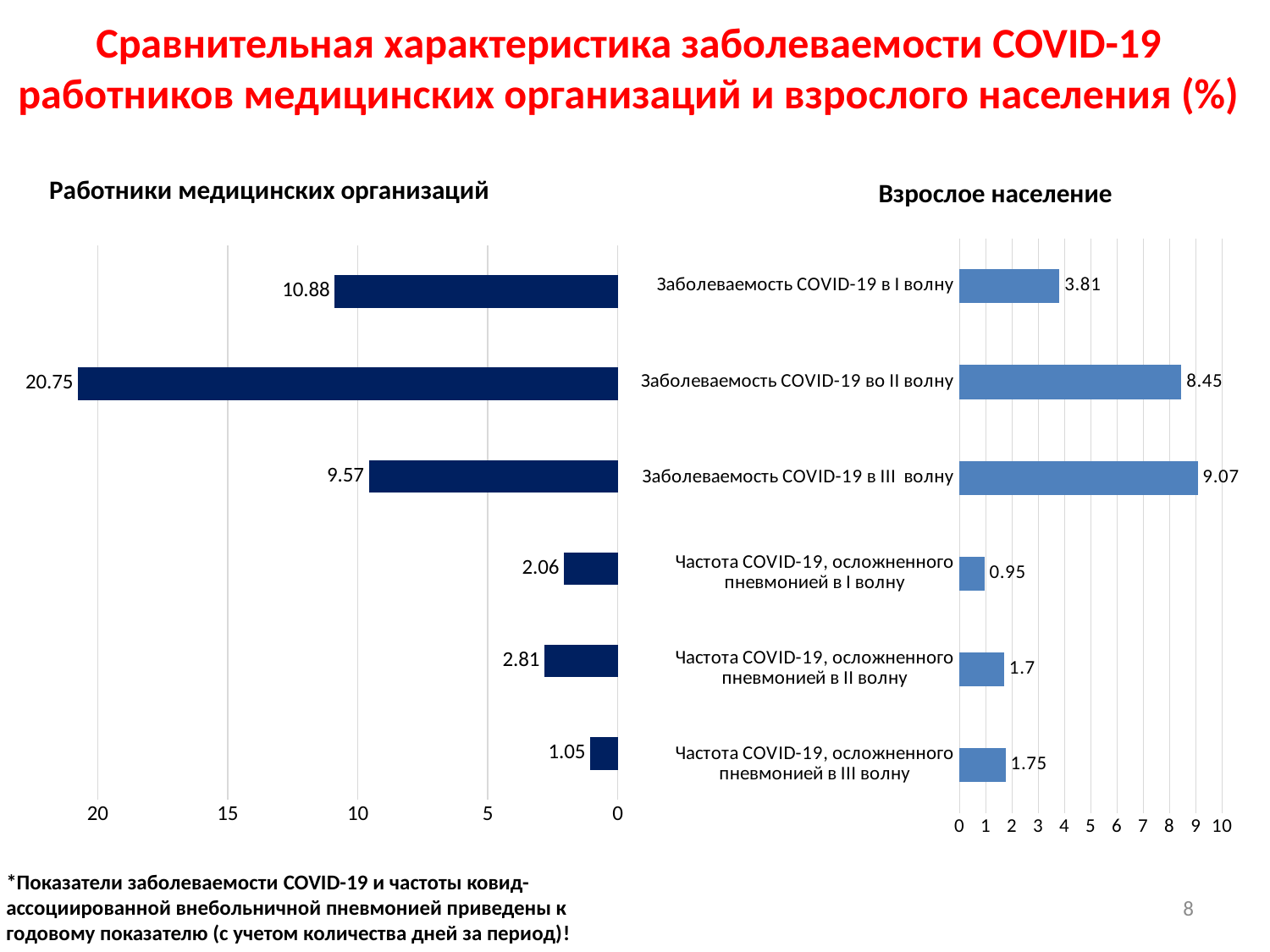
In the 'Взрослое население' chart, which category has the lowest value? Частота COVID-19, осложненного пневмонией в I волну In the 'Взрослое население' chart, what is the value for 'Заболеваемость COVID-19 в III волну'? 9.07 In the 'Работники медицинских организаций' chart, which category has the highest value? Заболеваемость COVID-19 во II волну In the 'Взрослое население' chart, what is the difference between the values for 'Заболеваемость COVID-19 во II волну' and 'Заболеваемость COVID-19 в I волну'? 4.64 In the 'Работники медицинских организаций' chart, which category has the lowest value? Частота COVID-19, осложненного пневмонией в III волну In the 'Взрослое население' chart, what is the value for 'Частота COVID-19, осложненного пневмонией в I волну'? 0.95 What type of chart is the 'Работники медицинских организаций' chart? Bar chart In the 'Работники медицинских организаций' chart, what is the difference between the values for 'Заболеваемость COVID-19 в I волну' and 'Заболеваемость COVID-19 в III волну'? 1.31 How many categories are shown in the 'Взрослое население' chart? 6 In the 'Работники медицинских организаций' chart, which is larger: the value for 'Частота COVID-19, осложненного пневмонией в I волну' or 'Частота COVID-19, осложненного пневмонией в II волну'? Частота COVID-19, осложненного пневмонией в II волну In the 'Работники медицинских организаций' chart, what is the value for 'Заболеваемость COVID-19 во II волну'? 20.75 In the 'Взрослое население' chart, which category has the highest value? Заболеваемость COVID-19 в III волну